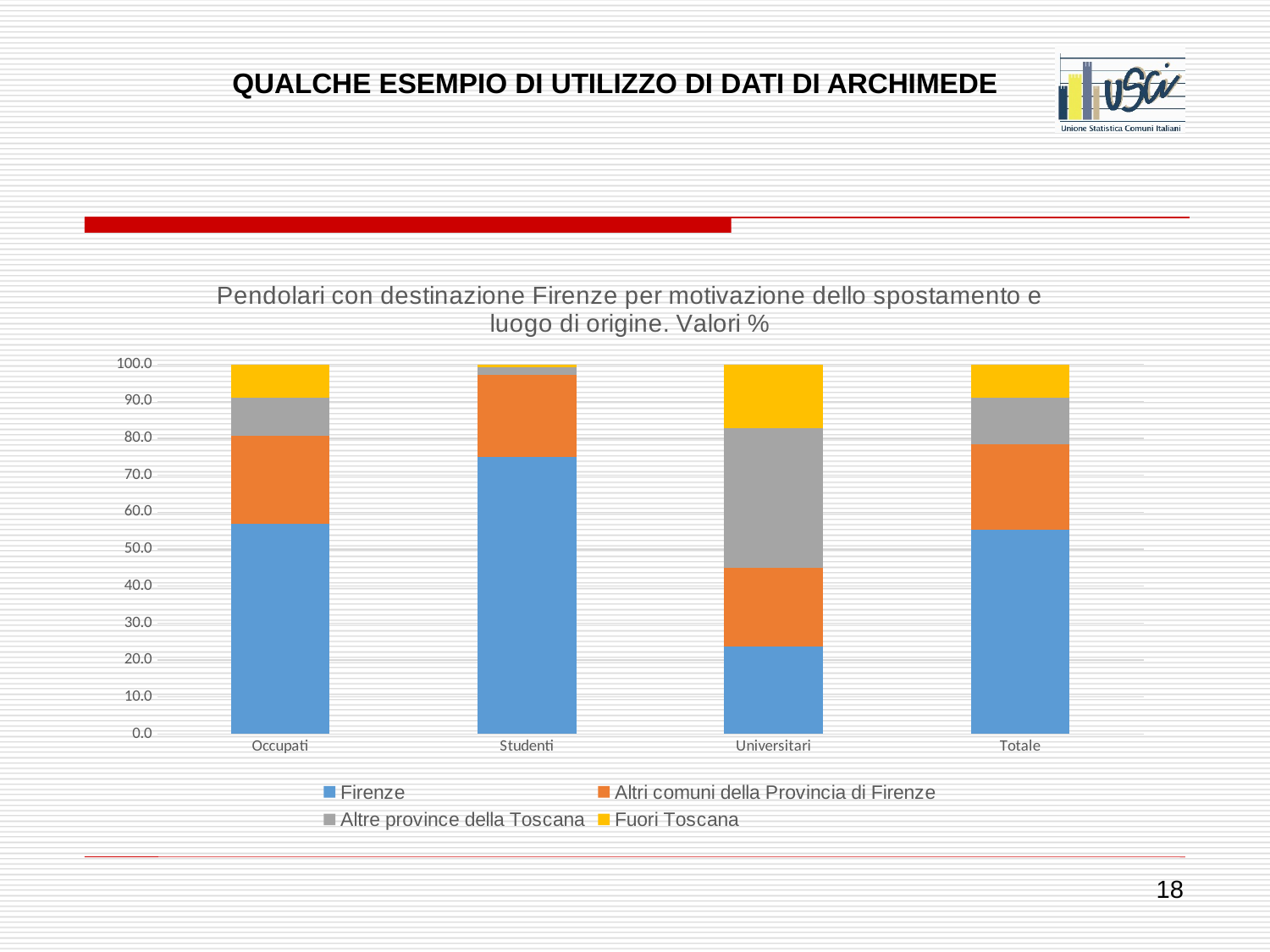
Which category has the largest Altre province della Toscana segment? Universitari Is the Firenze value for Studenti greater or less than 70? greater How many categories are shown on the x axis of the chart? 4 Is the Firenze value for Occupati greater or less than 50? greater What kind of chart is shown on the slide? Stacked bar chart Which colour represents the Fuori Toscana series in the chart? Yellow Which is larger, the Firenze segment for Occupati or for Universitari? Occupati Which category has the largest Fuori Toscana segment? Universitari Which category has the smallest Firenze segment? Universitari How many series does the legend list? 4 Which category has the largest Firenze segment? Studenti Is the Firenze value for Universitari greater or less than 30? less